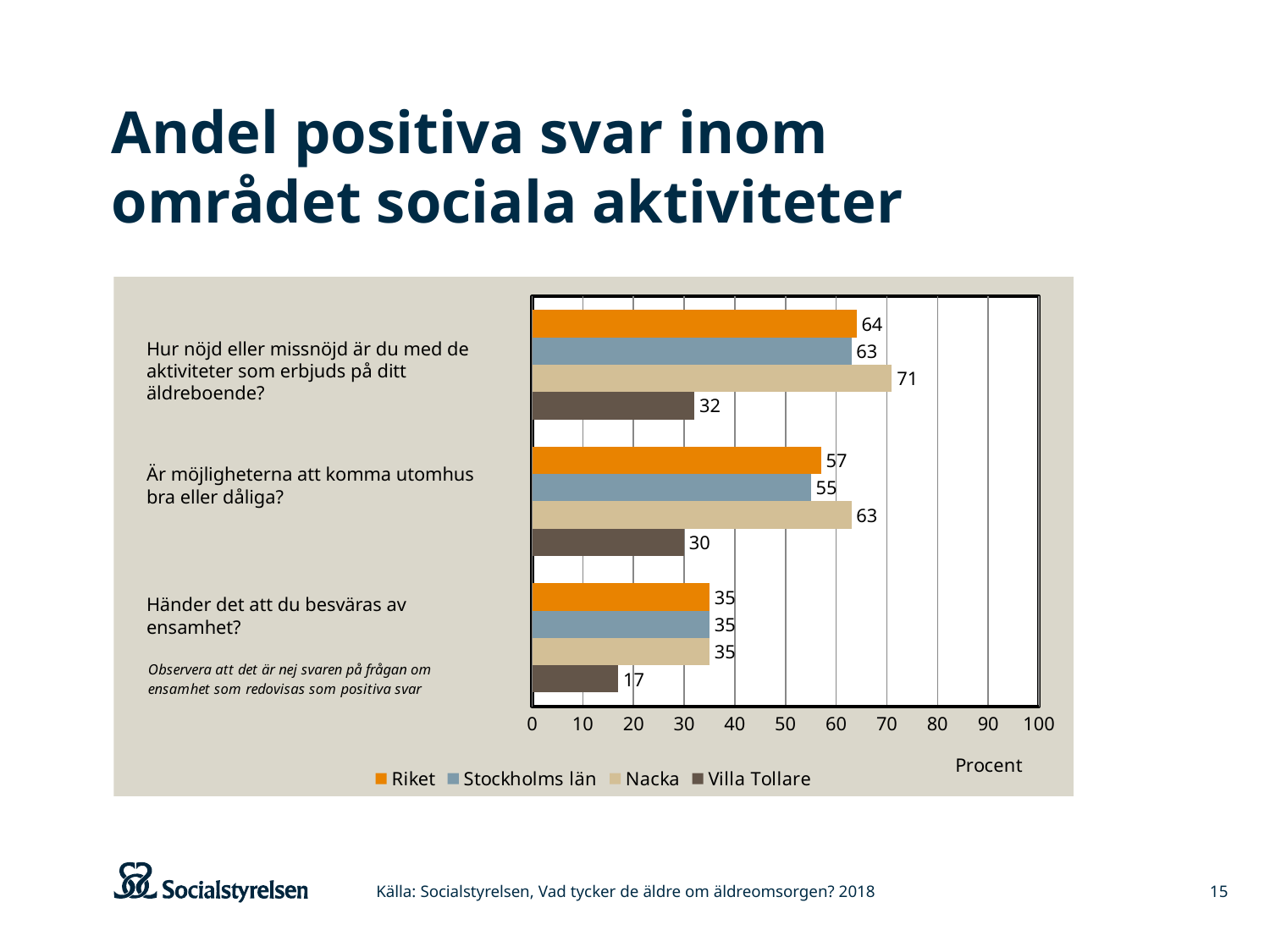
What is the difference between the Nacka and Villa Tollare values on the question "Är möjligheterna att komma utomhus bra eller dåliga?"? 33 What is the value for Villa Tollare on the question "Är möjligheterna att komma utomhus bra eller dåliga?"? 30 What is the value for Riket on the question "Händer det att du besväras av ensamhet?"? 35 What kind of chart is shown on the slide? Bar chart Is the value for Villa Tollare on the question "Hur nöjd eller missnöjd är du med de aktiviteter som erbjuds på ditt äldreboende?" greater or less than 40? less What is the label of the x axis? Procent Which series has the highest value on the question "Hur nöjd eller missnöjd är du med de aktiviteter som erbjuds på ditt äldreboende?"? Nacka How many series does the legend list? 4 What is the value for Nacka on the question "Hur nöjd eller missnöjd är du med de aktiviteter som erbjuds på ditt äldreboende?"? 71 Which is larger: the Riket value or the Stockholms län value on the question "Är möjligheterna att komma utomhus bra eller dåliga?"? Riket How many questions (categories) are shown on the chart? 3 Which series has the lowest value on the question "Händer det att du besväras av ensamhet?"? Villa Tollare